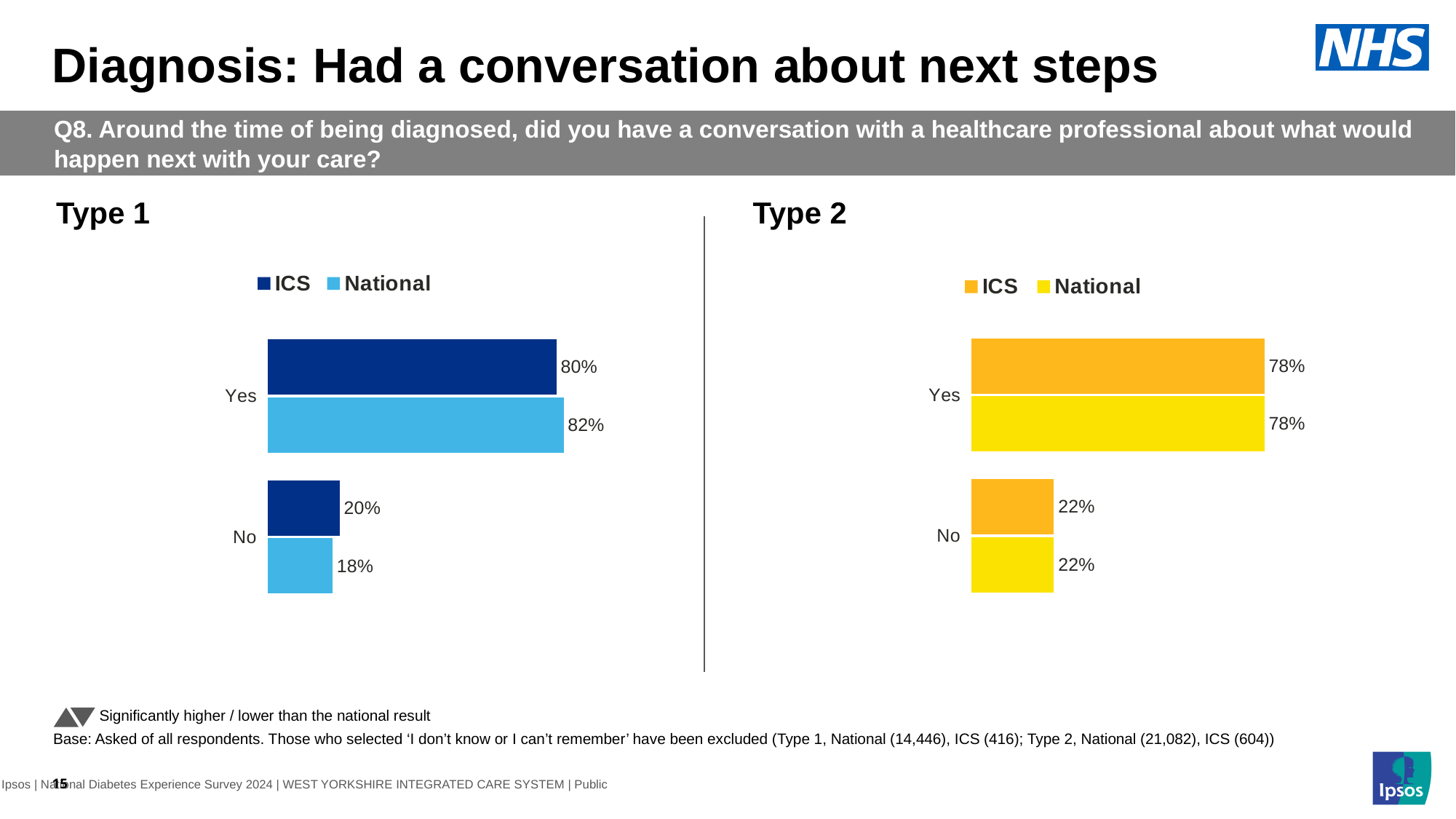
In the Type 1 chart, how many response categories are shown? 2 In the Type 1 chart, which is larger for No: ICS or National? ICS In the Type 1 chart, what is the total of the ICS values for Yes and No? 100% In the Type 2 chart, how many series does the legend list? 2 What type of chart is the Type 2 chart? Bar chart In the Type 1 chart, what is the difference between the National and ICS values for Yes? 2 percentage points In the Type 2 chart, what colour represents the ICS series? Orange In the Type 1 chart, what is the National value for No? 18% In the Type 2 chart, what is the National value for Yes? 78% In the Type 1 chart, what is the ICS value for Yes? 80% In the Type 1 chart, which series has the higher value for Yes? National In the Type 2 chart, what is the ICS value for No? 22%